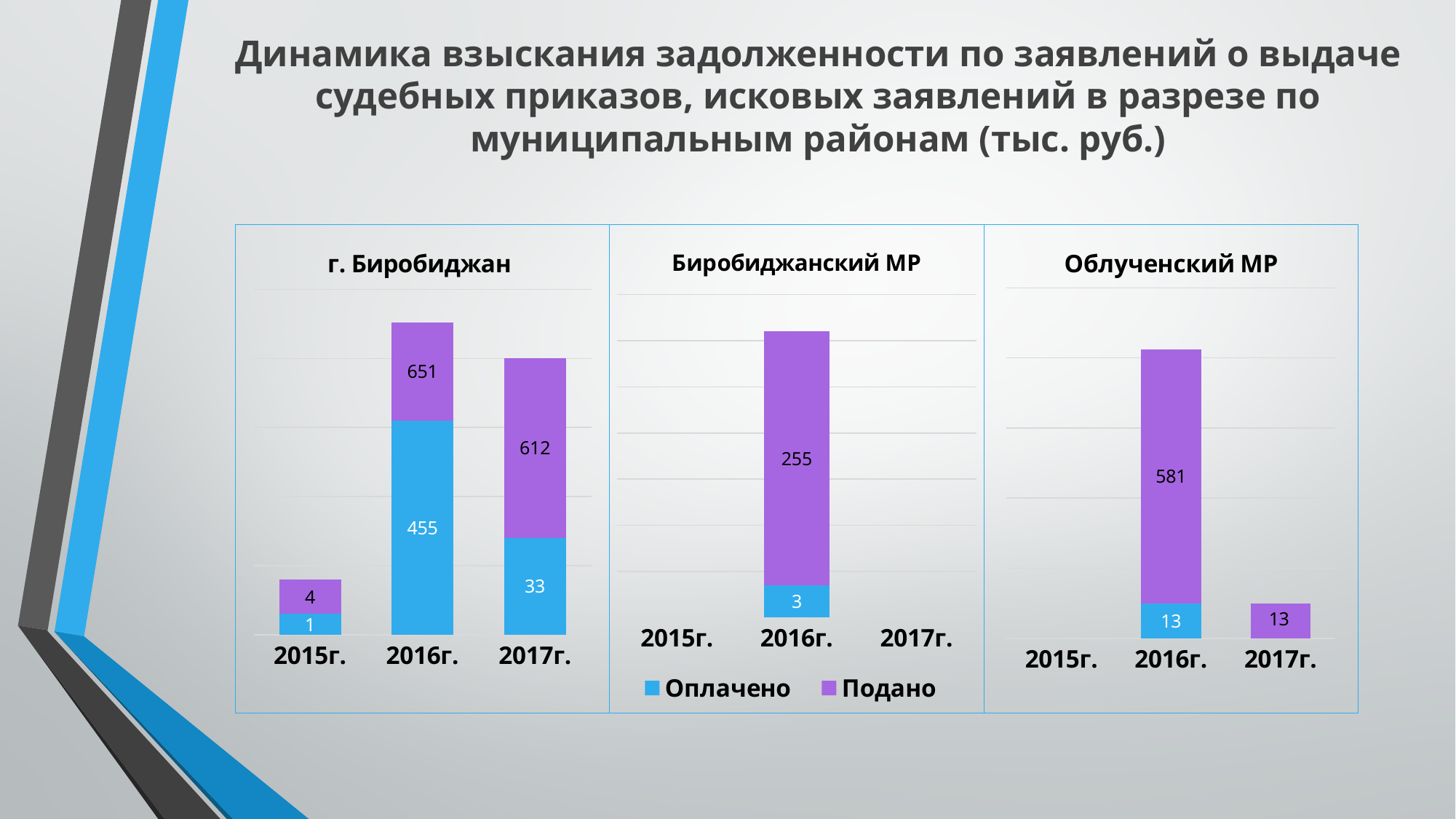
In the chart titled 'Облученский МР', is the 'Подано' value for 2016г. larger or smaller than the 'Подано' value for 2017г.? larger In the chart titled 'г. Биробиджан', which year has the lowest 'Подано' value? 2015г. In the chart titled 'Биробиджанский МР', what is the value of 'Подано' for 2016г.? 255 In the chart titled 'г. Биробиджан', what is the total of the stacked bar for 2016г.? 1106 In the chart titled 'г. Биробиджан', which year has the highest 'Оплачено' value? 2016г. In the chart titled 'г. Биробиджан', what is the value of 'Подано' for 2016г.? 651 In the chart titled 'Облученский МР', what is the value of 'Оплачено' for 2016г.? 13 In the chart titled 'г. Биробиджан', what is the value of 'Оплачено' for 2017г.? 33 In the chart titled 'г. Биробиджан', what is the difference between 'Подано' for 2016г. and 'Подано' for 2017г.? 39 What kind of chart is the chart titled 'Биробиджанский МР'? stacked bar chart In the chart titled 'Облученский МР', what is the total of the stacked bar for 2016г.? 594 How many series does the legend on the slide list? 2